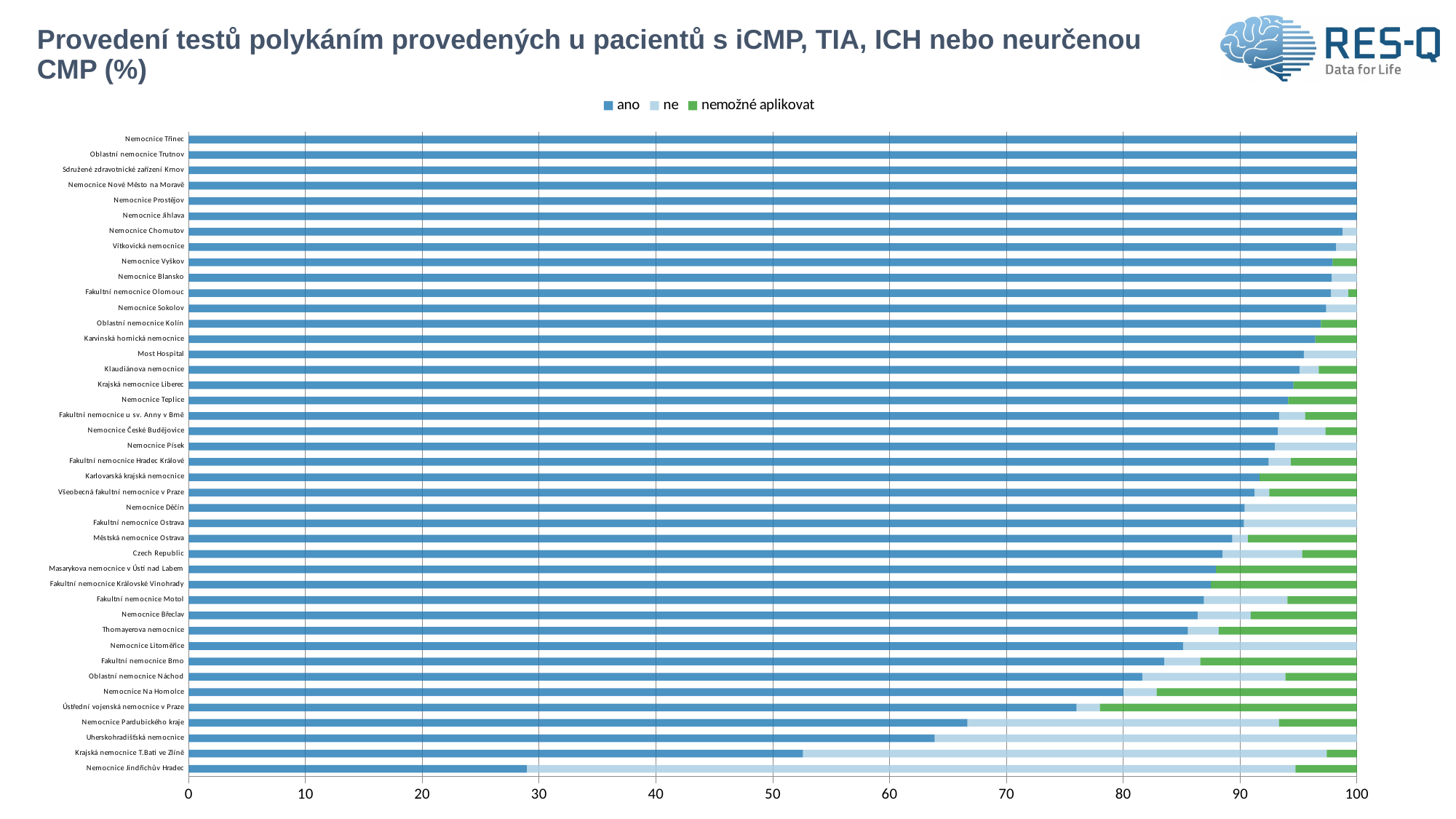
Is the "ano" value for Krajská nemocnice T.Bati ve Zlíně greater or less than 50? greater Which category has the lowest value for "ano"? Nemocnice Jindřichův Hradec How many series does the legend list? 3 What kind of chart is shown on the slide? bar chart What are the three series named in the legend? ano, ne, nemožné aplikovat Is the "ano" value for Czech Republic greater or less than 90? less Is the "ano" value for Nemocnice Jindřichův Hradec greater or less than 40? less Which has a larger "ano" value: Uherskohradišťská nemocnice or Krajská nemocnice T.Bati ve Zlíně? Uherskohradišťská nemocnice How many hospitals/categories are plotted on the chart? 42 Do the "ano" values rise or fall going from the top of the chart to the bottom? fall Which colour represents the series "nemožné aplikovat"? green